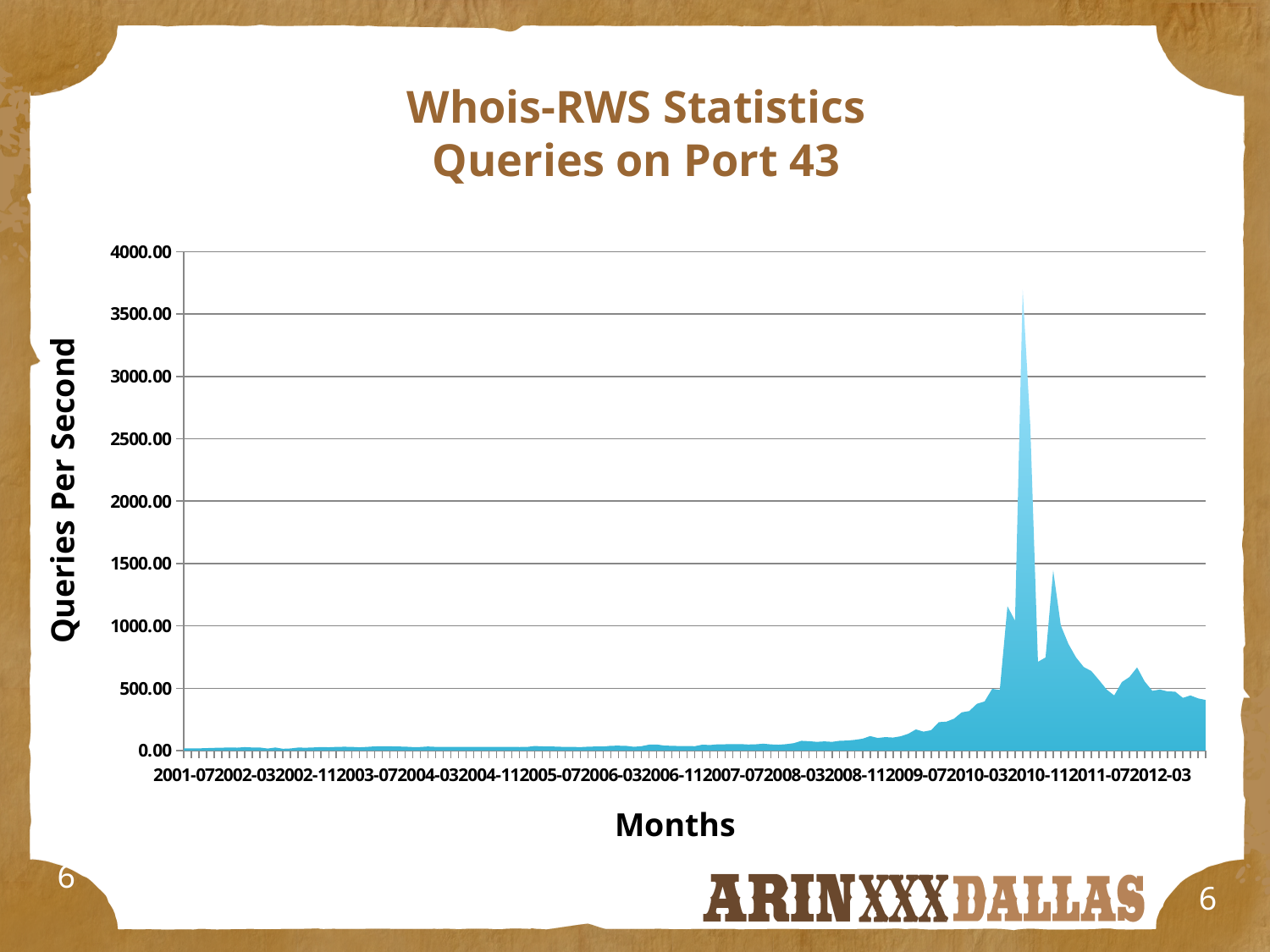
Is the value at 2012-03 greater or less than 1000? less Do the values rise or fall from the highest peak to 2012-03? fall Do the values generally rise or fall from 2001-07 to 2010? rise In which year does the highest peak of the chart occur? 2010 What is the label of the vertical axis? Queries Per Second How many month labels are shown along the horizontal axis? 17 Is the highest peak of the chart greater or less than 3500? greater Is the value at 2008-03 greater or less than 500? less What kind of chart is shown on the slide? area chart What is the highest value shown on the vertical axis? 4000.00 What is the title of the chart on the slide? Whois-RWS Statistics Queries on Port 43